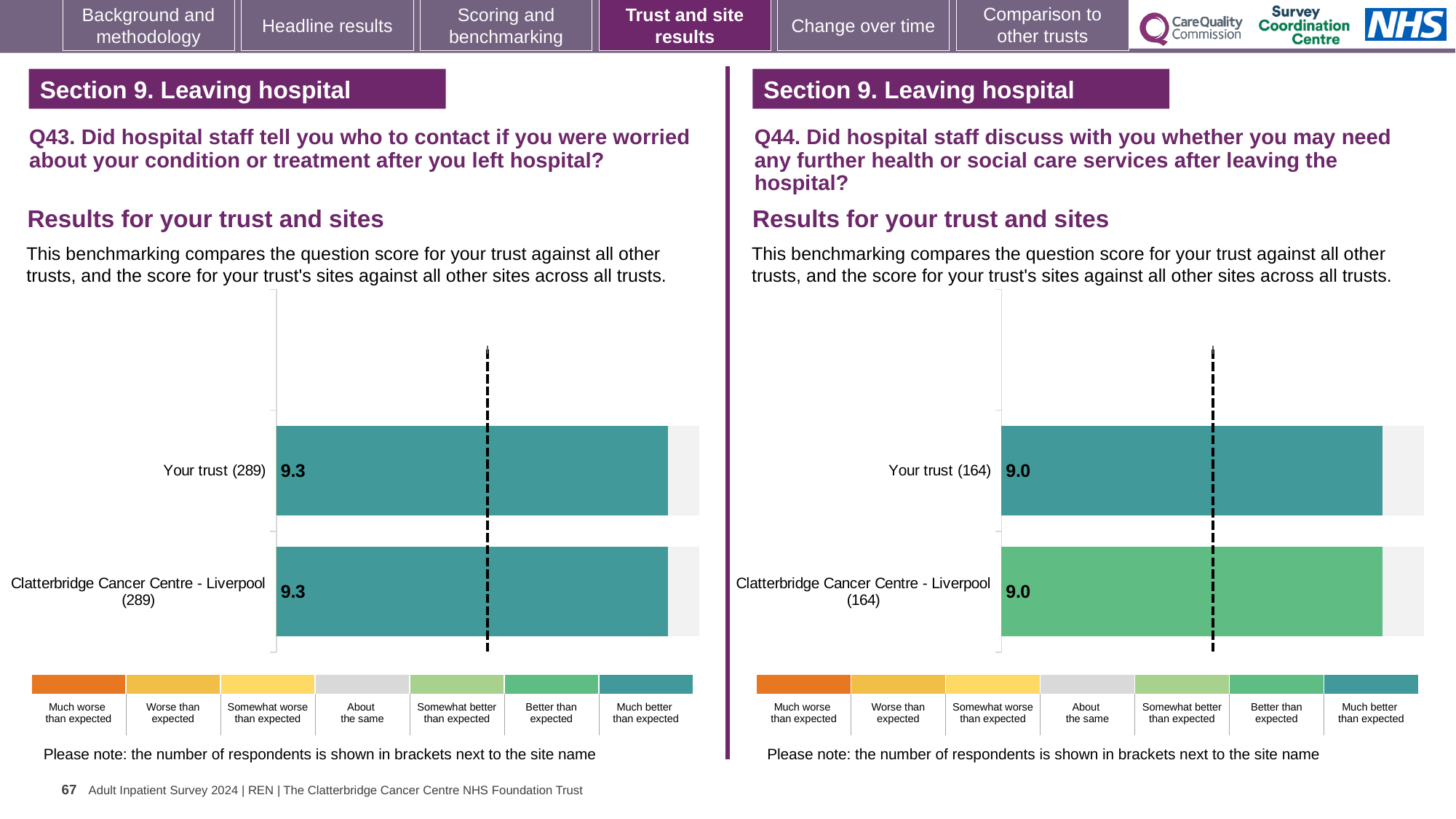
How many bars are plotted on the Q44 chart (right)? 2 On the Q43 chart (left), what is the score for Clatterbridge Cancer Centre - Liverpool? 9.3 How many bars are plotted on the Q43 chart (left)? 2 On the Q43 chart (left), how many respondents are shown in brackets for Your trust? 289 On the Q44 chart (right), what is the score for Your trust? 9.0 Is the score for Your trust on the Q44 chart (right) larger or smaller than the score for Your trust on the Q43 chart (left)? Smaller What kind of chart is the Q43 chart (left)? Bar chart On the Q44 chart (right), how many respondents are shown in brackets for Clatterbridge Cancer Centre - Liverpool? 164 On the Q43 chart (left), what is the score for Your trust? 9.3 On the Q43 chart (left), what is the difference between the score for Your trust and the score for Clatterbridge Cancer Centre - Liverpool? 0.0 On the Q44 chart (right), what is the score for Clatterbridge Cancer Centre - Liverpool? 9.0 On the Q44 chart (right), what is the difference between the score for Your trust and the score for Clatterbridge Cancer Centre - Liverpool? 0.0